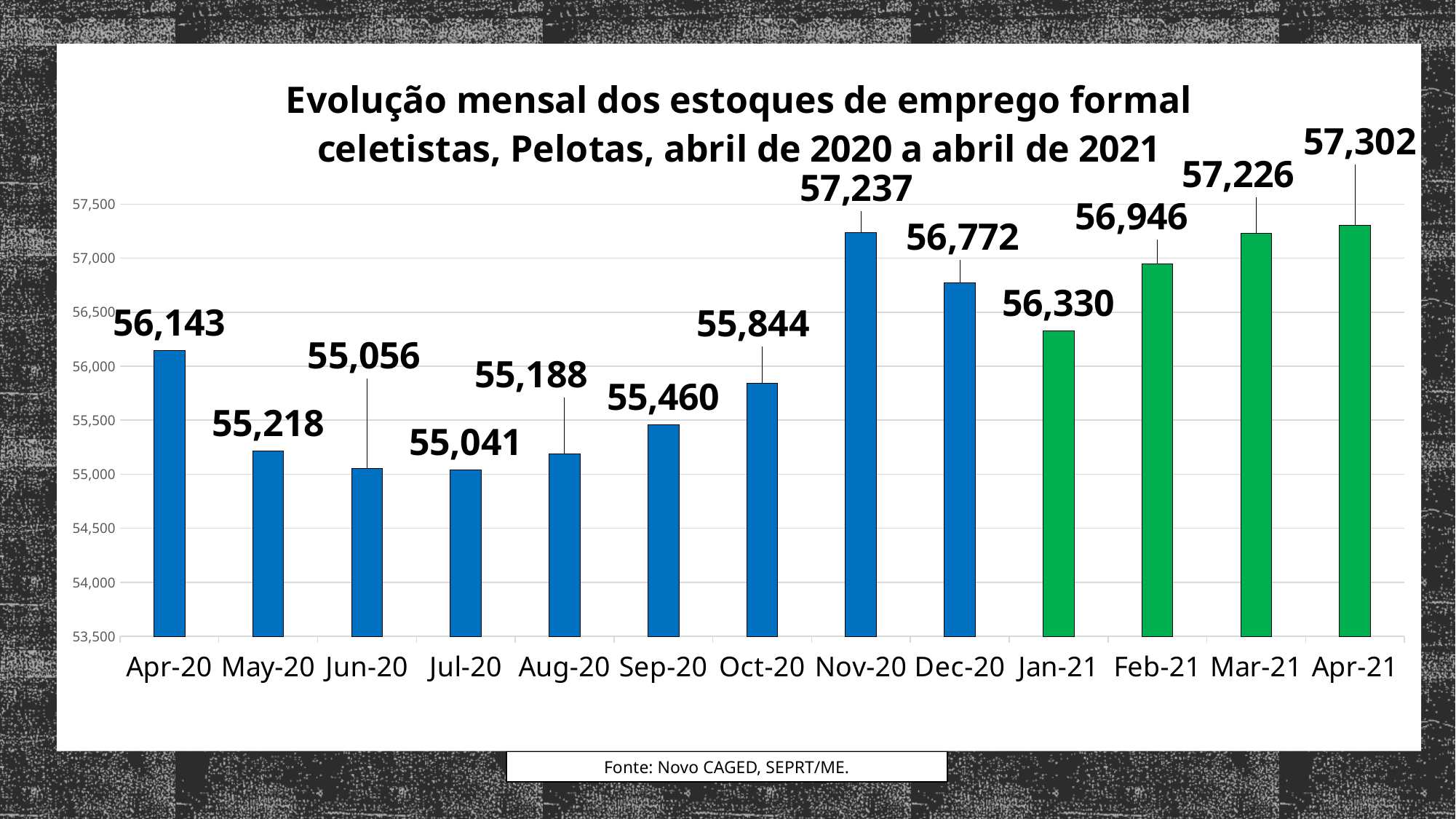
What kind of chart is shown on the slide? bar chart What colour are the bars for the 2021 months? green What is the value for Nov-20? 57,237 What is the difference between the values for Nov-20 and Dec-20? 465 Is the value for Feb-21 greater or less than 57,000? less How many months are shown on the x axis? 13 Which month has the lowest value? Jul-20 Which is larger, the value for Oct-20 or the value for Sep-20? Oct-20 What is the value for Jan-21? 56,330 What is the difference between the values for Apr-21 and Apr-20? 1,159 Which month has the highest value? Apr-21 What is the value for Jul-20? 55,041